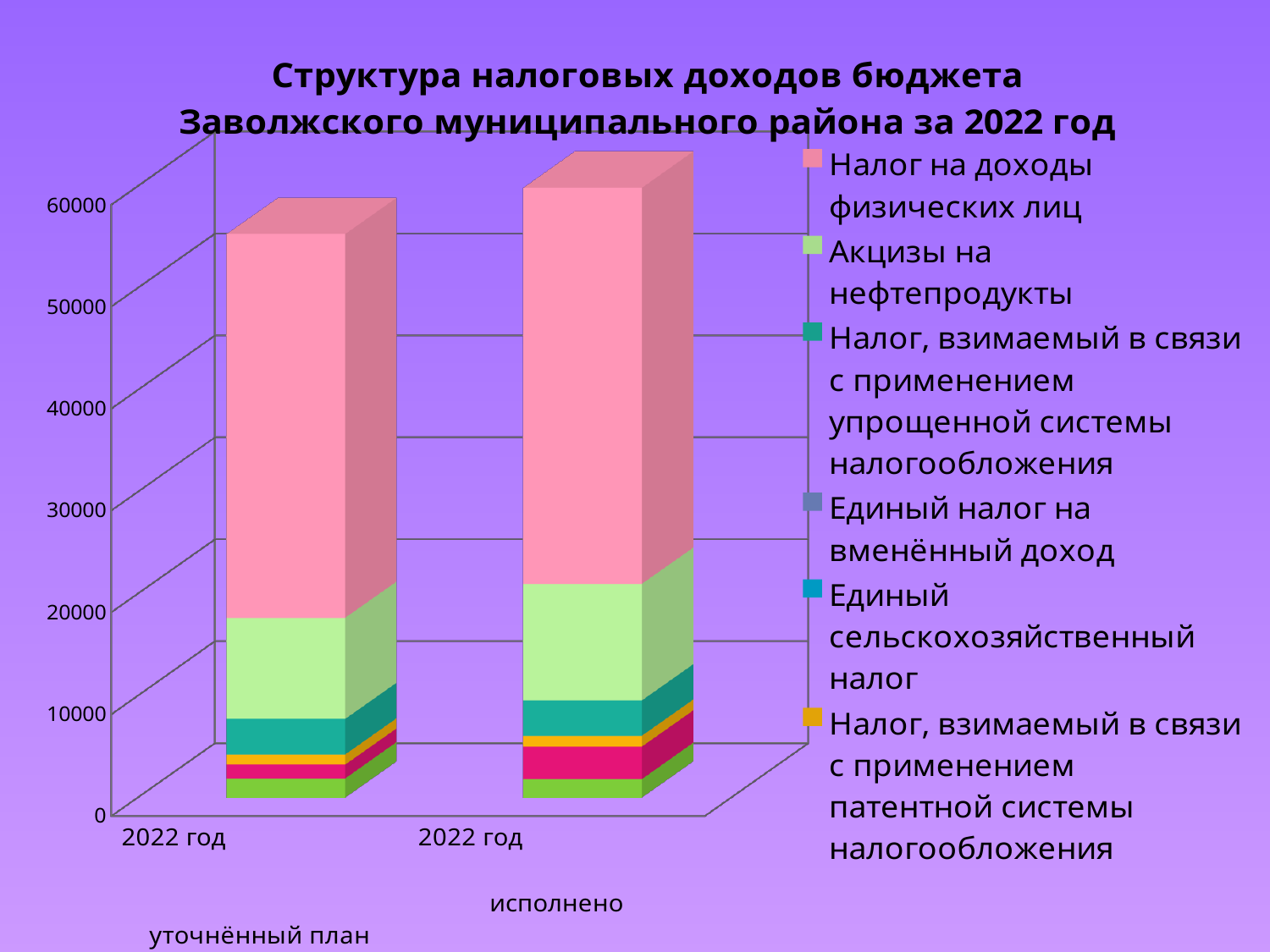
What is the title of the chart? Структура налоговых доходов бюджета Заволжского муниципального района за 2022 год Is the total of the уточнённый план bar greater or less than 60000? less Is the total of the уточнённый план bar greater or less than 40000? greater What kind of chart is shown on the slide? Stacked bar chart Is the total of the исполнено bar greater or less than 40000? greater Does the total tax revenue rise or fall from уточнённый план to исполнено? rise How many series does the legend list? 6 Which series forms the largest segment in the уточнённый план bar? Налог на доходы физических лиц Which bar is taller, уточнённый план or исполнено? исполнено Which legend entry is shown in pink, the top segment of each bar? Налог на доходы физических лиц How many bars are plotted in the chart? 2 Which series forms the largest segment in the исполнено bar? Налог на доходы физических лиц